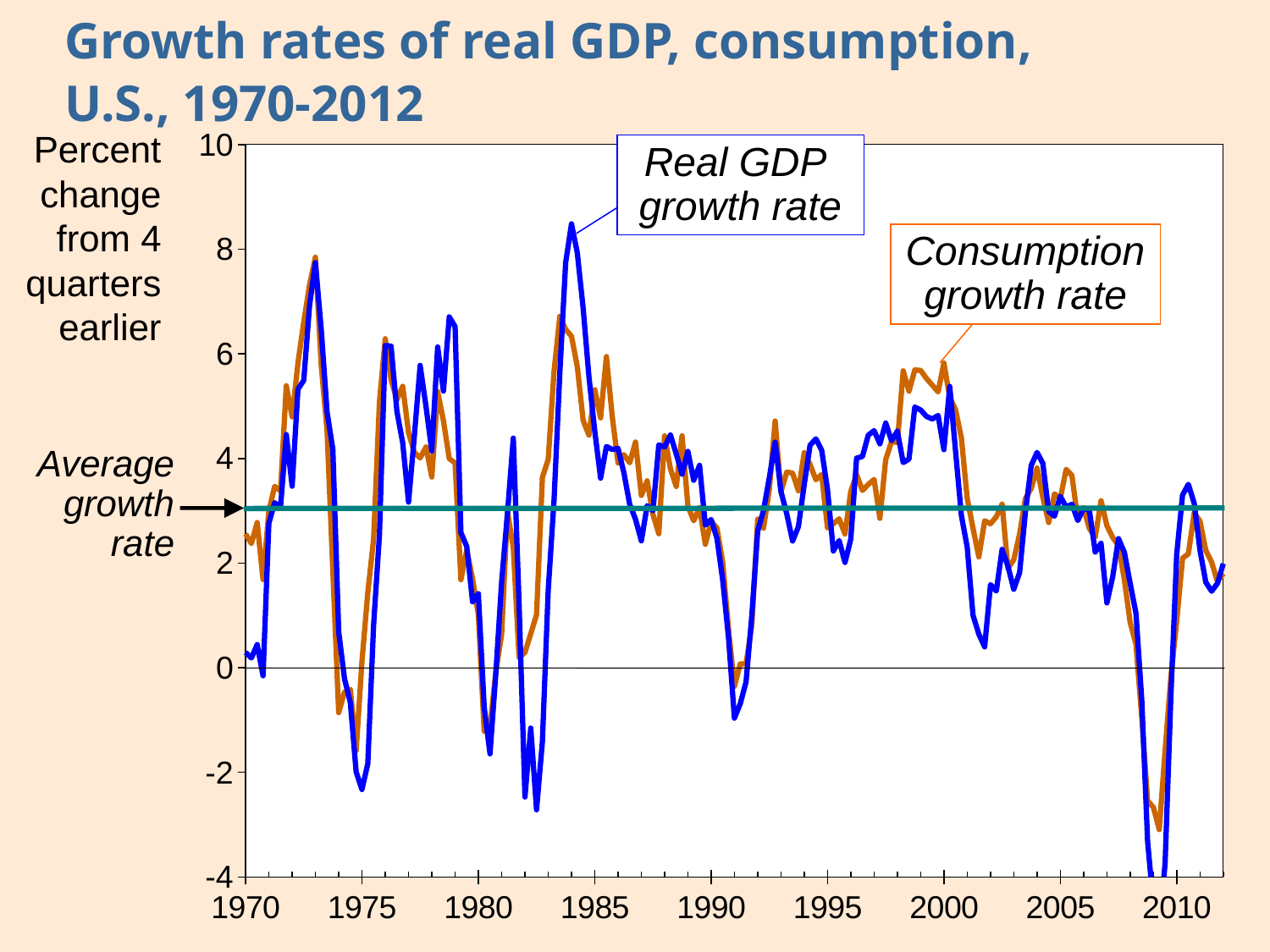
Is the peak of the Real GDP growth rate around 1984 greater or less than 8? greater Is the Consumption growth rate peak around 1973 greater or less than 6? greater Does the Real GDP growth rate rise or fall between 2007 and 2009? fall What colour is the Real GDP growth rate line? blue Is the Average growth rate line greater or less than 4? less What kind of chart is shown on the slide? line chart How many growth rate series are labelled with callout boxes on the chart? 2 Which series reaches the lowest point on the chart, Real GDP growth rate or Consumption growth rate? Real GDP growth rate What is the title of the chart? Growth rates of real GDP, consumption, U.S., 1970-2012 Which series reaches the highest peak on the chart, Real GDP growth rate or Consumption growth rate? Real GDP growth rate